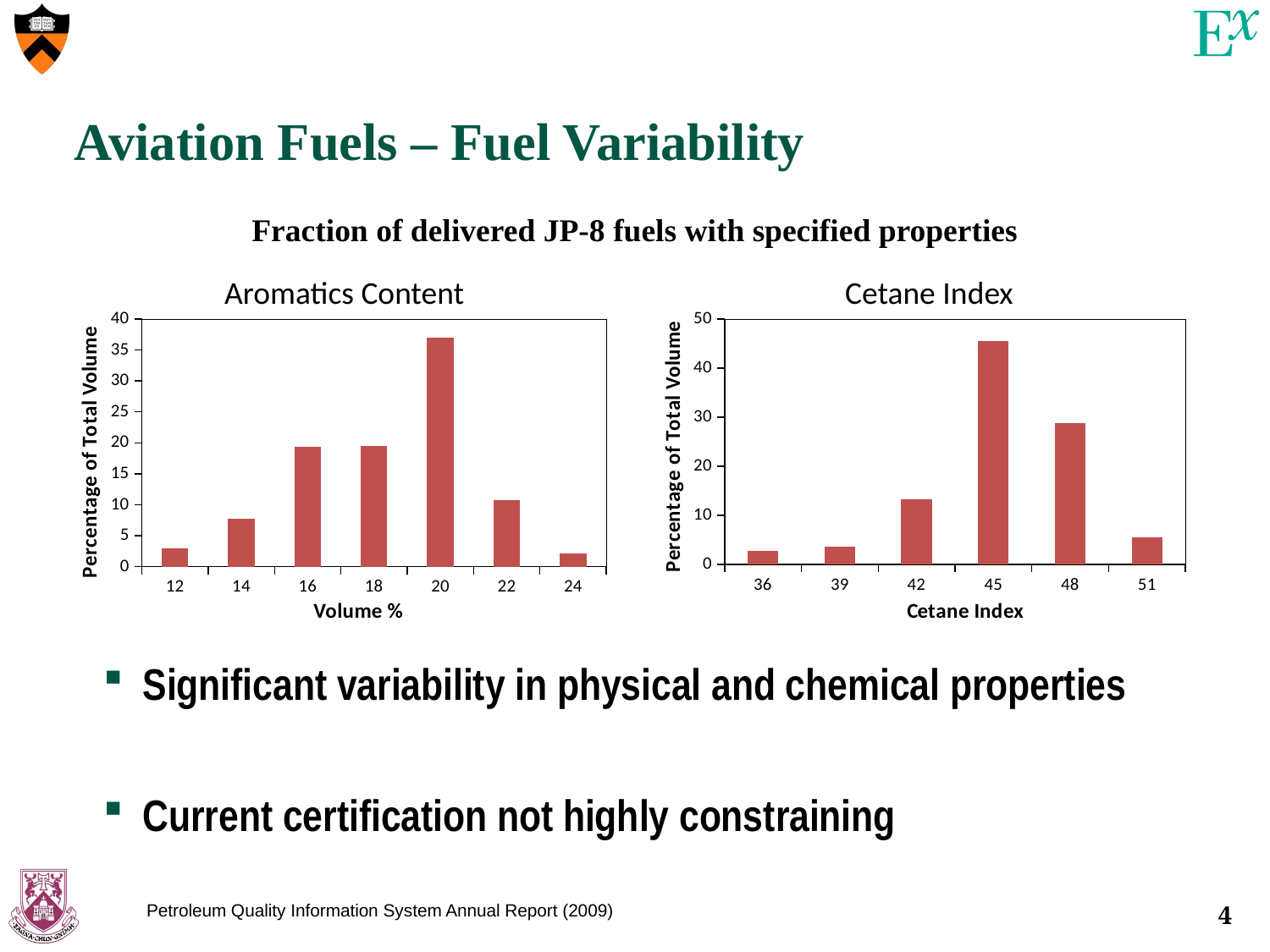
In the Cetane Index chart, which has the larger value, Cetane Index 42 or Cetane Index 48? 48 How many categories are shown on the x axis of the Aromatics Content chart? 7 In the Cetane Index chart, which Cetane Index category has the highest percentage of total volume? 45 In the Aromatics Content chart, which Volume % category has the highest percentage of total volume? 20 What kind of chart is the Cetane Index chart? bar chart In the Aromatics Content chart, is the value for 20 Volume % greater or less than 35? greater In the Aromatics Content chart, is the value for 22 Volume % greater or less than 15? less In the Aromatics Content chart, which has the larger value, 14 Volume % or 22 Volume %? 22 In the Cetane Index chart, is the value for Cetane Index 42 greater or less than 10? greater